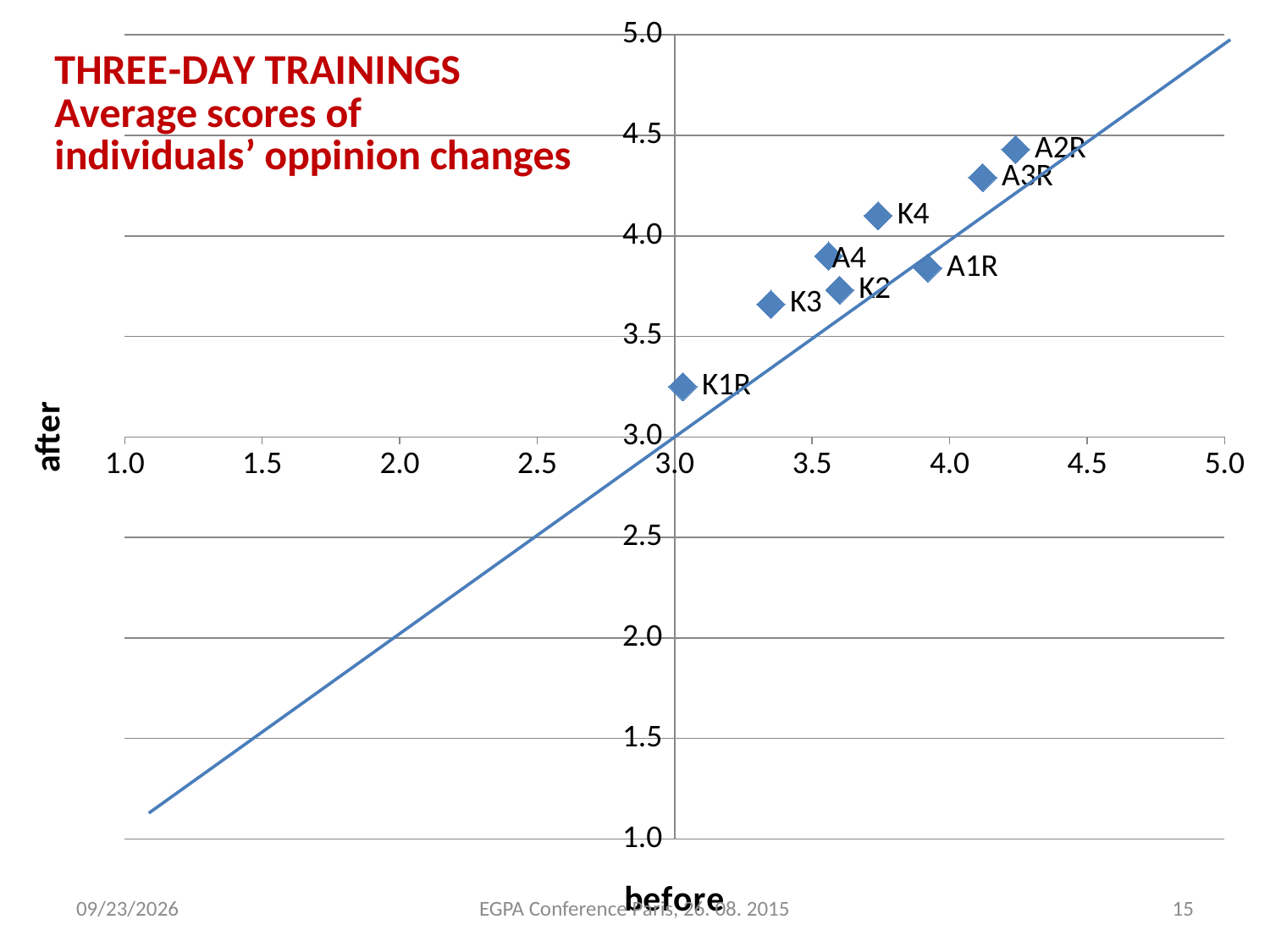
Is the 'before' value for K3 greater or less than 3.5? less Which has the higher 'after' score, K4 or A1R? K4 Is the 'before' value for A2R greater or less than 4.0? greater Is the 'after' value for K4 greater or less than 4.0? greater What is the label of the horizontal axis? before Which point has the lowest 'after' score? K1R How many labelled data points are plotted on the chart? 8 Which point has the highest 'after' score? A2R What kind of chart is shown on the slide? scatter chart What is the label of the vertical axis? after Which point has the lowest 'before' score? K1R